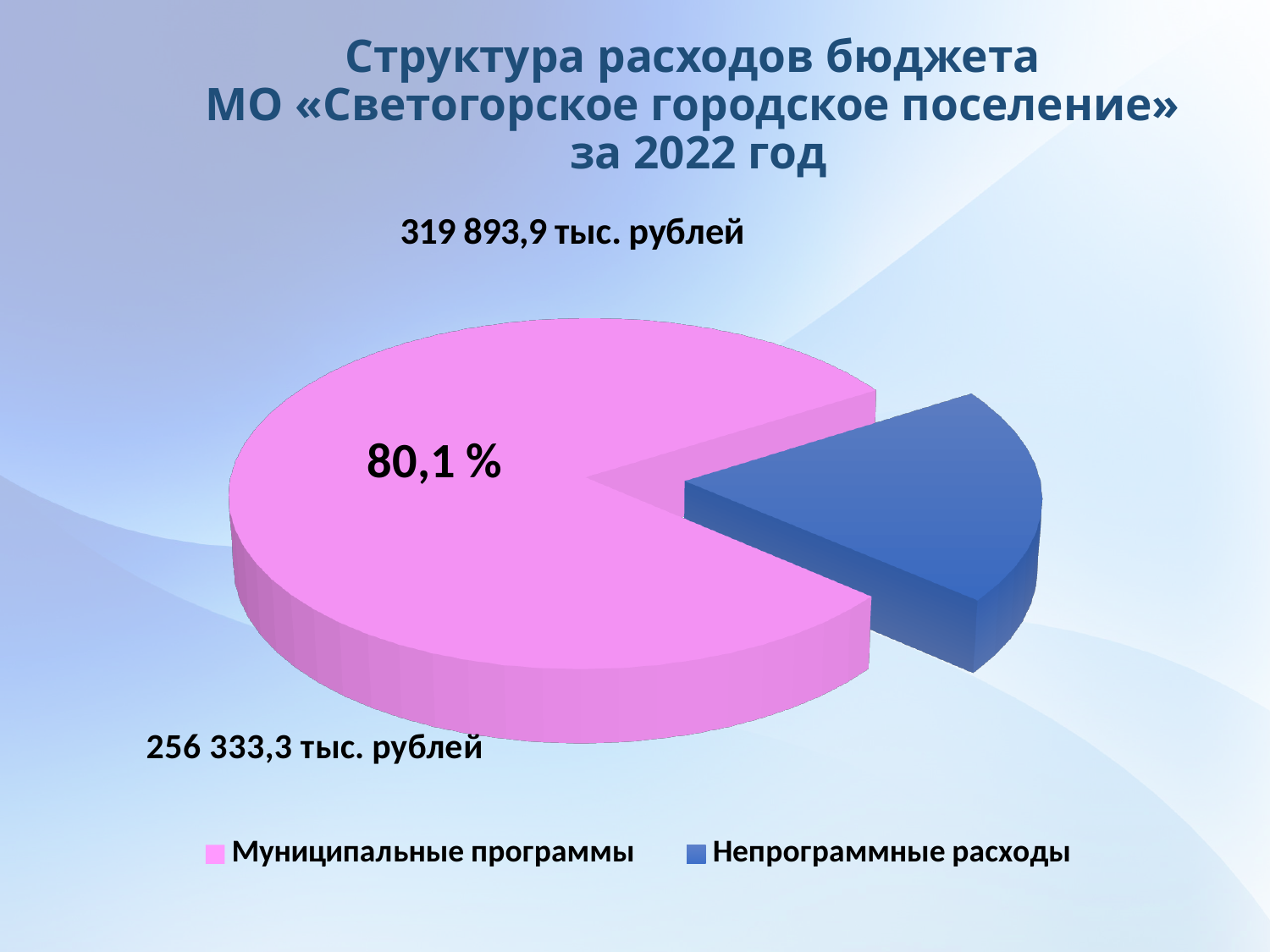
What total amount is shown above the pie chart? 319 893,9 тыс. рублей How many entries does the legend list? 2 What colour is the Муниципальные программы slice? pink What year does the chart title refer to? 2022 Which is larger: Муниципальные программы or Непрограммные расходы? Муниципальные программы Which category has the largest slice of the pie? Муниципальные программы What value is shown for Муниципальные программы? 256 333,3 тыс. рублей Does the Муниципальные программы slice account for more or less than half of the pie? more What kind of chart is shown on the slide? pie chart What percentage share is labelled on the Муниципальные программы slice? 80,1 % How many slices does the pie chart have? 2 Which category has the smallest slice of the pie? Непрограммные расходы